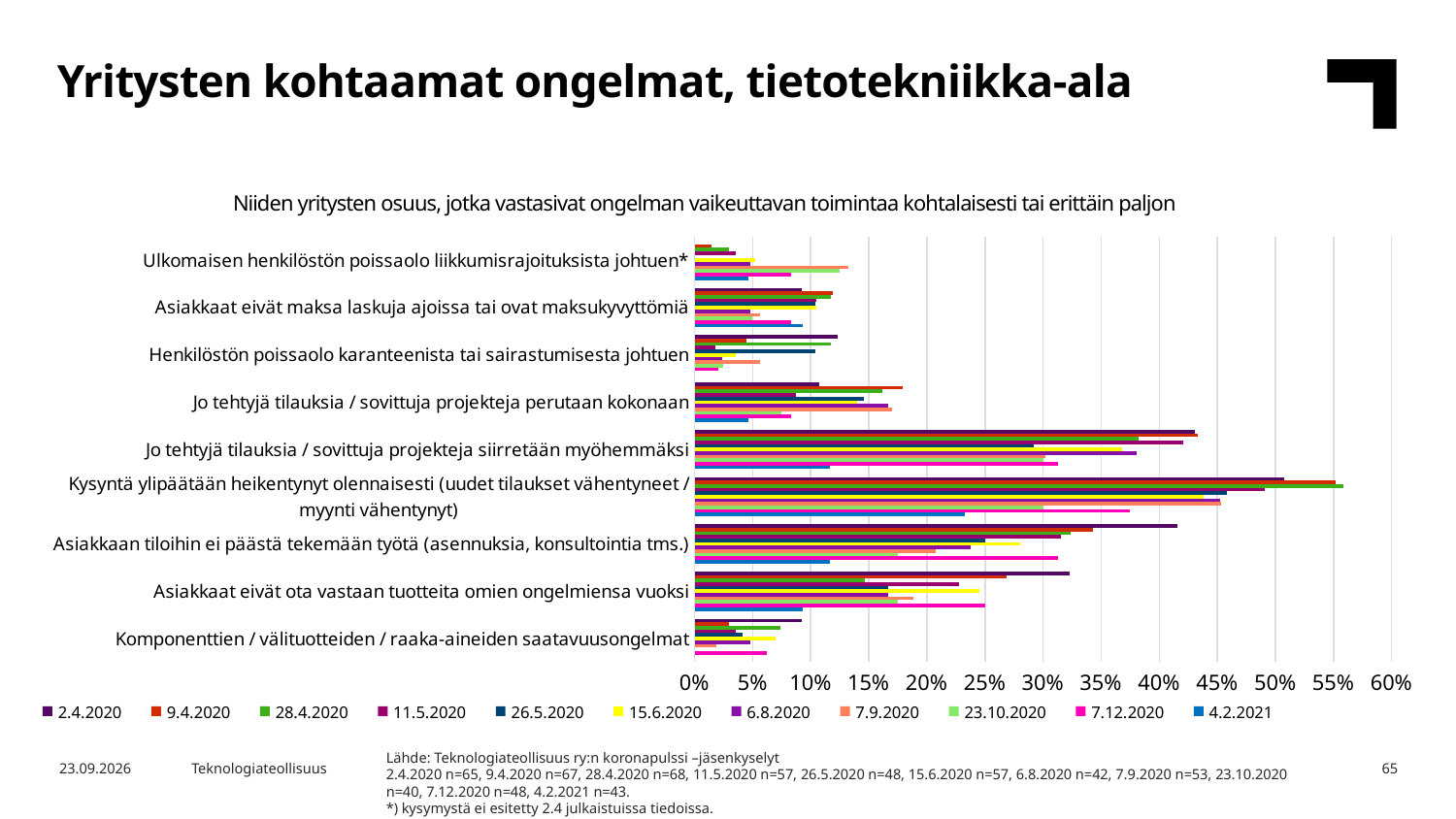
Which category has the highest values across the series? Kysyntä ylipäätään heikentynyt olennaisesti (uudet tilaukset vähentyneet / myynti vähentynyt) Is the value for 'Asiakkaan tiloihin ei päästä tekemään työtä' in the 2.4.2020 series greater or less than 35%? greater In the 2.4.2020 series, which is larger: 'Kysyntä ylipäätään heikentynyt olennaisesti' or 'Jo tehtyjä tilauksia / sovittuja projekteja siirretään myöhemmäksi'? Kysyntä ylipäätään heikentynyt olennaisesti How many problem categories are listed on the chart's vertical axis? 9 How many series (survey dates) does the legend list? 11 Is the value for 'Jo tehtyjä tilauksia / sovittuja projekteja siirretään myöhemmäksi' in the 2.4.2020 series greater or less than 40%? greater Is the value for 'Komponenttien / välituotteiden / raaka-aineiden saatavuusongelmat' in the 2.4.2020 series greater or less than 5%? greater In the 2.4.2020 series, which is larger: 'Komponenttien / välituotteiden / raaka-aineiden saatavuusongelmat' or 'Asiakkaat eivät ota vastaan tuotteita omien ongelmiensa vuoksi'? Asiakkaat eivät ota vastaan tuotteita omien ongelmiensa vuoksi What is the maximum value shown on the chart's horizontal axis? 60% What is the last series listed in the chart legend? 4.2.2021 What kind of chart is shown on the slide? Bar chart